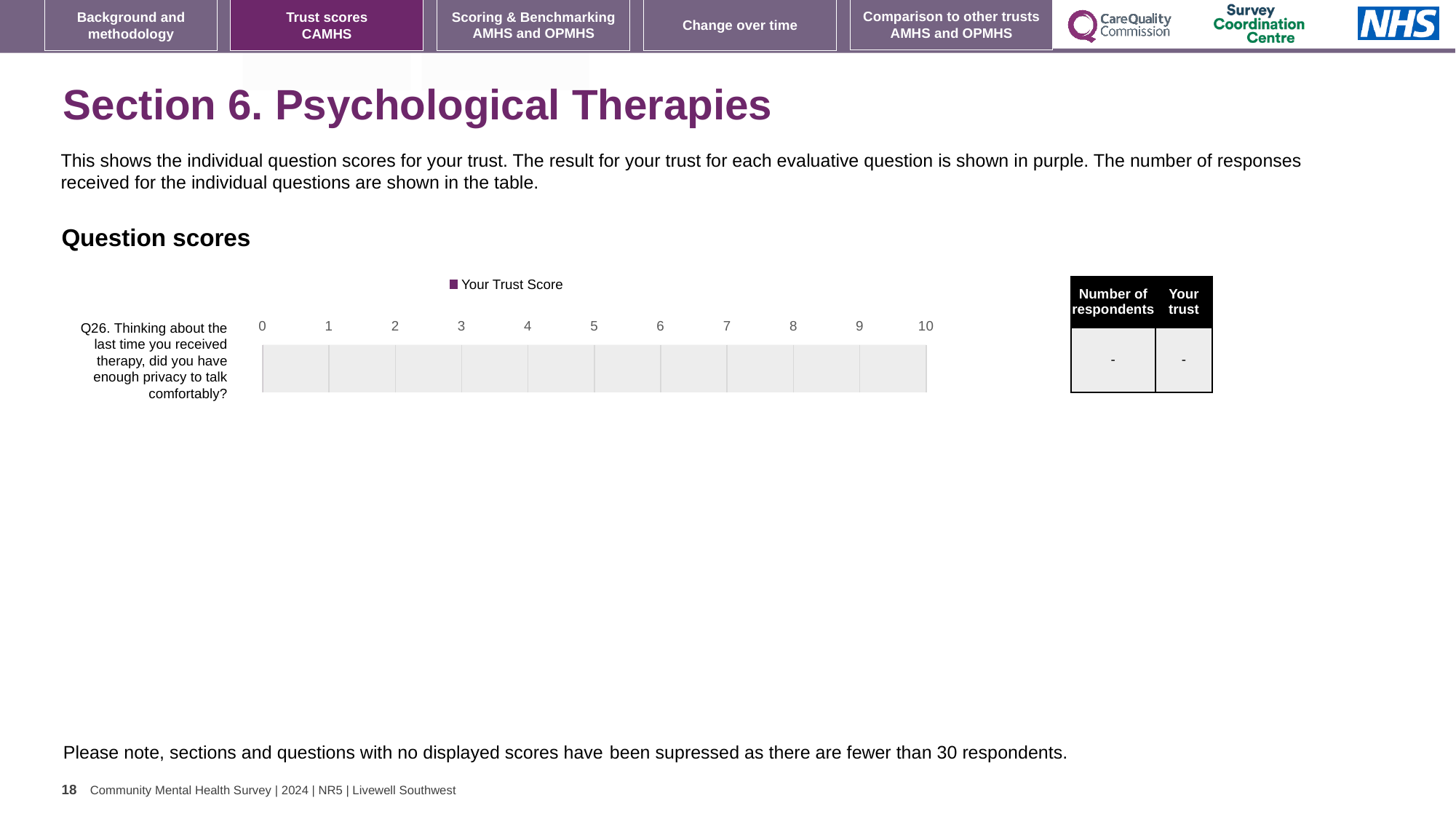
What kind of chart is shown under the heading "Question scores"? bar chart What value is shown in the "Number of respondents" column of the table for Q26? - How many questions (categories) are shown on the Question scores chart? 1 How many series does the legend of the Question scores chart list? 1 Is a bar plotted for Q26 on the Question scores chart? No What is the name of the series in the legend of the Question scores chart? Your Trust Score What value is shown in the "Your trust" column of the table for Q26? - What is the highest value shown on the x axis of the Question scores chart? 10